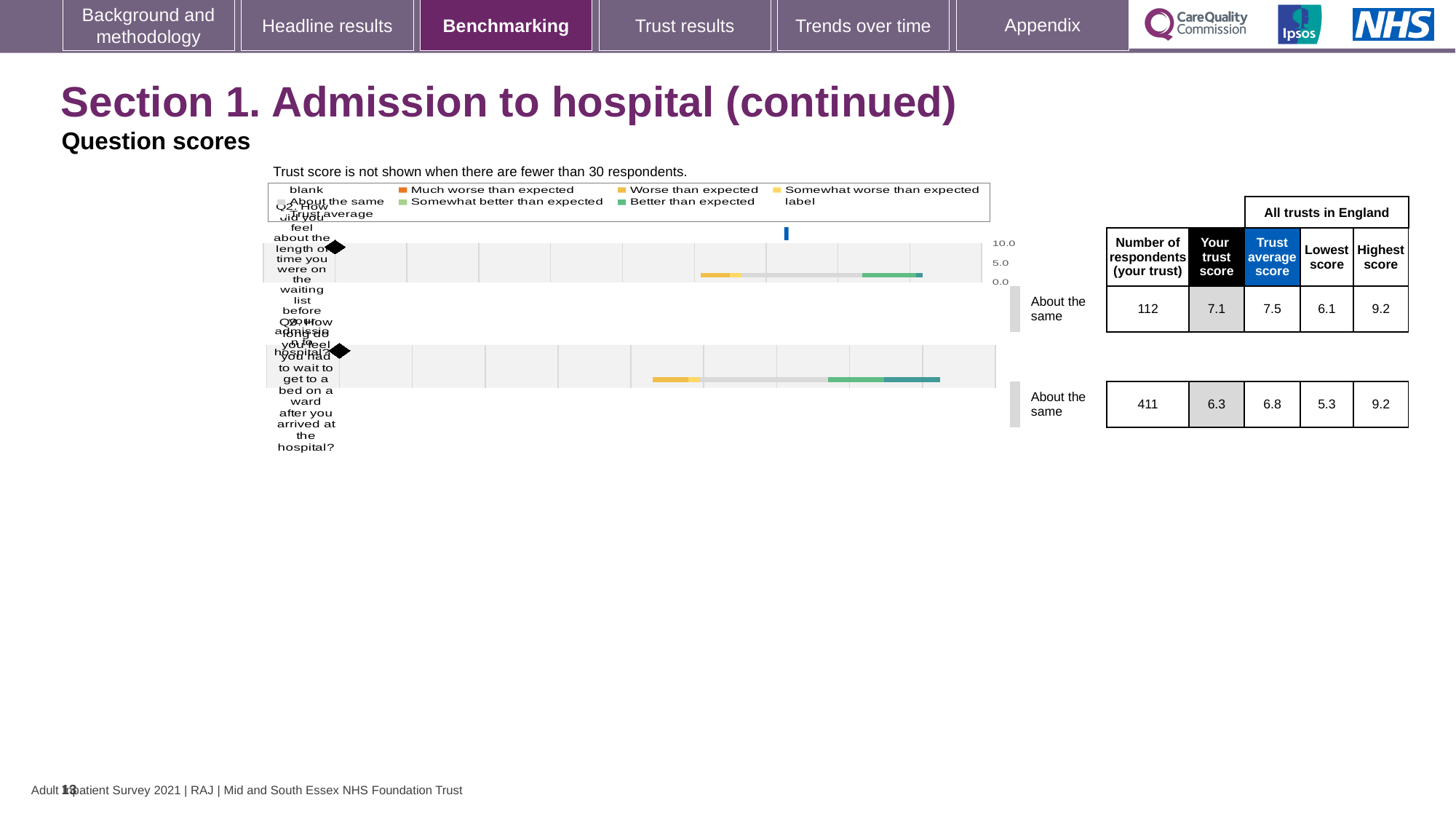
What is the highest score across all trusts in England for Q2? 9.2 Which question has the higher trust score, Q2 or Q3? Q2 What is the difference between the highest and lowest scores for Q3? 3.9 What is the trust score for Q2 (how did you feel about the length of time you were on the waiting list before admission)? 7.1 What is the lowest score across all trusts in England for Q3? 5.3 What is the trust score for Q3 (how long did you feel you had to wait to get to a bed on a ward after you arrived at the hospital)? 6.3 What is the difference between the trust average score and your trust score for Q2? 0.4 What is the maximum value shown on the chart's score axis? 10.0 How many questions are plotted on the chart? 2 What is the trust average score for Q2? 7.5 What kind of chart is used to show the question scores? Bar chart What is the number of respondents for Q3? 411